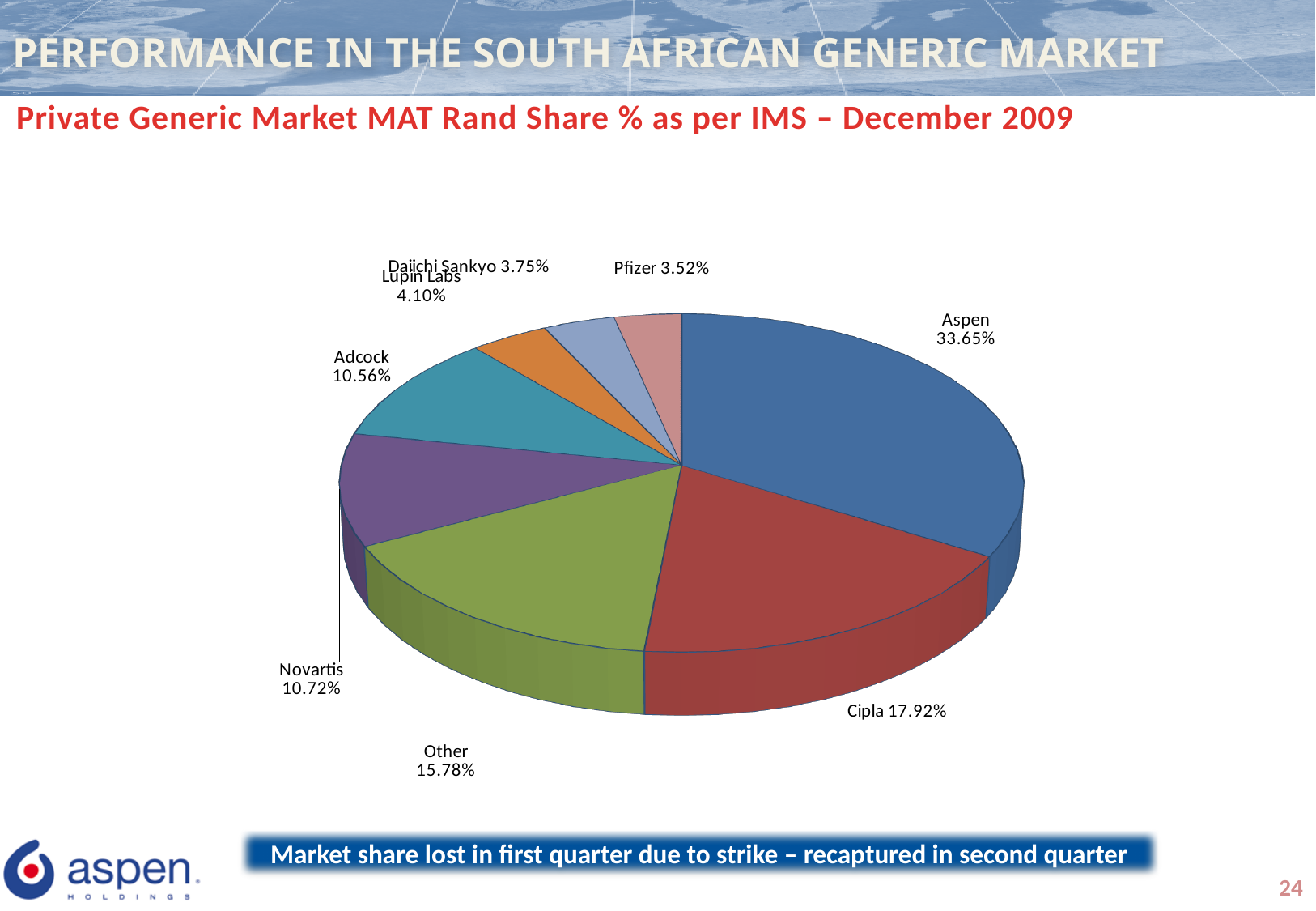
Which is larger, the share for Adcock or the share for Other? Other What is the market share for Cipla? 17.92% Which slice has the smallest share of the pie? Pfizer What is the market share for Aspen? 33.65% What is the market share for Novartis? 10.72% What kind of chart is shown on the slide? Pie chart Which company has the largest share of the pie? Aspen How many slices does the pie chart have? 8 What is the market share for Pfizer? 3.52% What is the subtitle of the chart shown on the slide? Private Generic Market MAT Rand Share % as per IMS – December 2009 What is the difference between Aspen's share and Cipla's share? 15.73% What is the market share for Lupin Labs? 4.10%